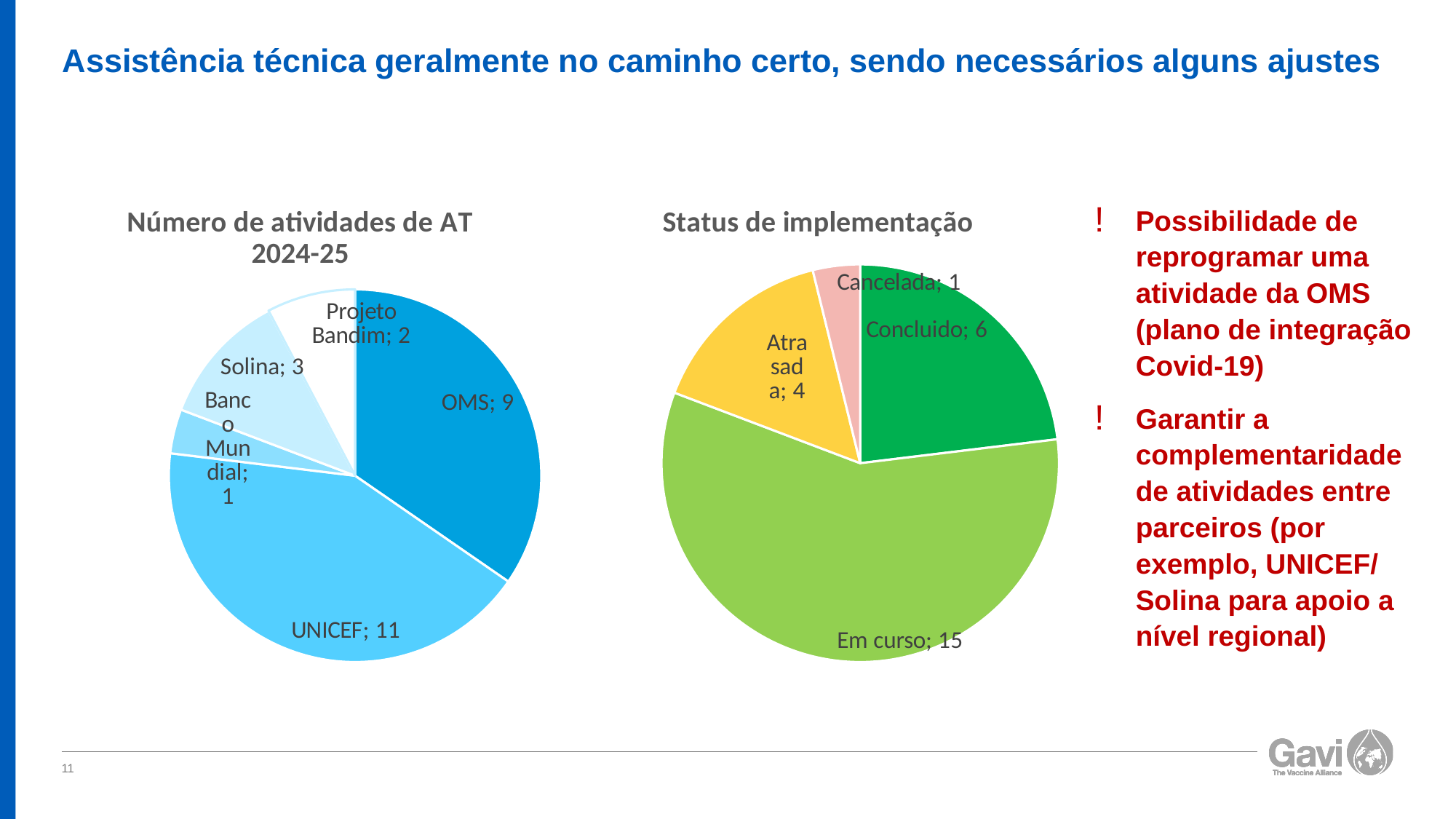
In the chart titled 'Status de implementação', is the value for 'Concluido' larger or smaller than the value for 'Atrasada'? Larger In the chart titled 'Número de atividades de AT 2024-25', which partner has the smallest number of activities? Banco Mundial In the chart titled 'Status de implementação', what share of the total do the 'Em curso' activities represent? 57.7% In the chart titled 'Número de atividades de AT 2024-25', what is the difference between the UNICEF and OMS values? 2 In the chart titled 'Status de implementação', how many activities are 'Em curso'? 15 In the chart titled 'Número de atividades de AT 2024-25', how many activities are attributed to UNICEF? 11 In the chart titled 'Número de atividades de AT 2024-25', how many partner categories are shown? 5 In the chart titled 'Número de atividades de AT 2024-25', which partner has the largest number of activities? UNICEF What type of chart is 'Status de implementação'? Pie chart In the chart titled 'Número de atividades de AT 2024-25', how many activities are attributed to OMS? 9 In the chart titled 'Status de implementação', how many activities are 'Atrasada'? 4 In the chart titled 'Status de implementação', which status has the fewest activities? Cancelada